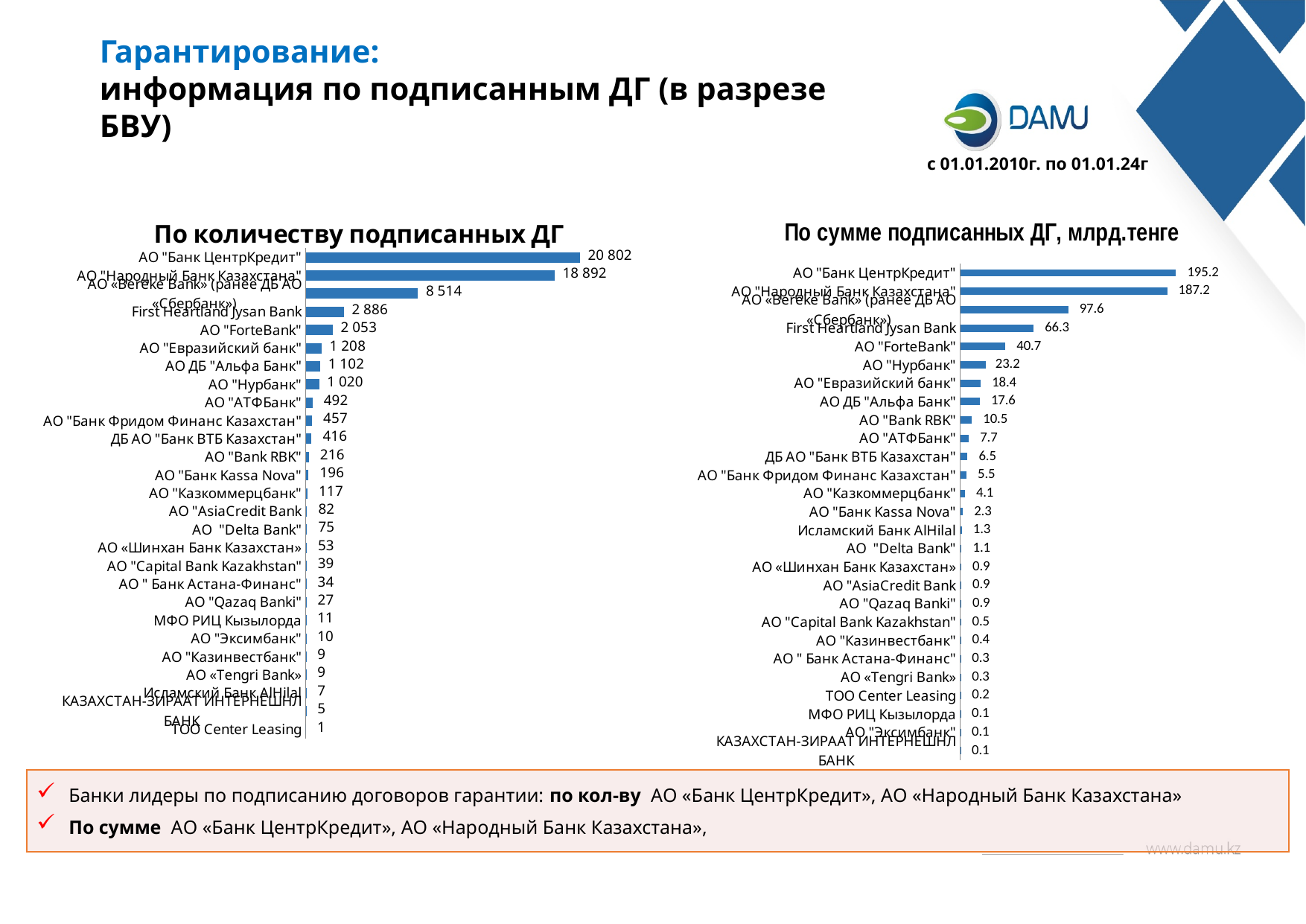
What kind of chart is 'По количеству подписанных ДГ'? Bar chart In the chart 'По количеству подписанных ДГ', what is the value for АО "ForteBank"? 2 053 What is the title of the chart on the right side of the slide? По сумме подписанных ДГ, млрд.тенге In the chart 'По количеству подписанных ДГ', which bank has the highest value? АО "Банк ЦентрКредит" How many categories are shown in the chart 'По сумме подписанных ДГ, млрд.тенге'? 27 In the chart 'По количеству подписанных ДГ', what is the difference between АО "Банк ЦентрКредит" and АО "Народный Банк Казахстана"? 1 910 In the chart 'По сумме подписанных ДГ, млрд.тенге', what is the value for АО "Нурбанк"? 23.2 In the chart 'По сумме подписанных ДГ, млрд.тенге', what is the difference between АО "Банк ЦентрКредит" and АО "Народный Банк Казахстана"? 8.0 In the chart 'По количеству подписанных ДГ', which is larger: АО "АТФБанк" or АО "Банк Фридом Финанс Казахстан"? АО "АТФБанк" In the chart 'По сумме подписанных ДГ, млрд.тенге', what is the value for First Heartland Jysan Bank? 66.3 In the chart 'По количеству подписанных ДГ', which category has the lowest value? ТОО Center Leasing In the chart 'По сумме подписанных ДГ, млрд.тенге', which is larger: АО "Евразийский банк" or АО ДБ "Альфа Банк"? АО "Евразийский банк"